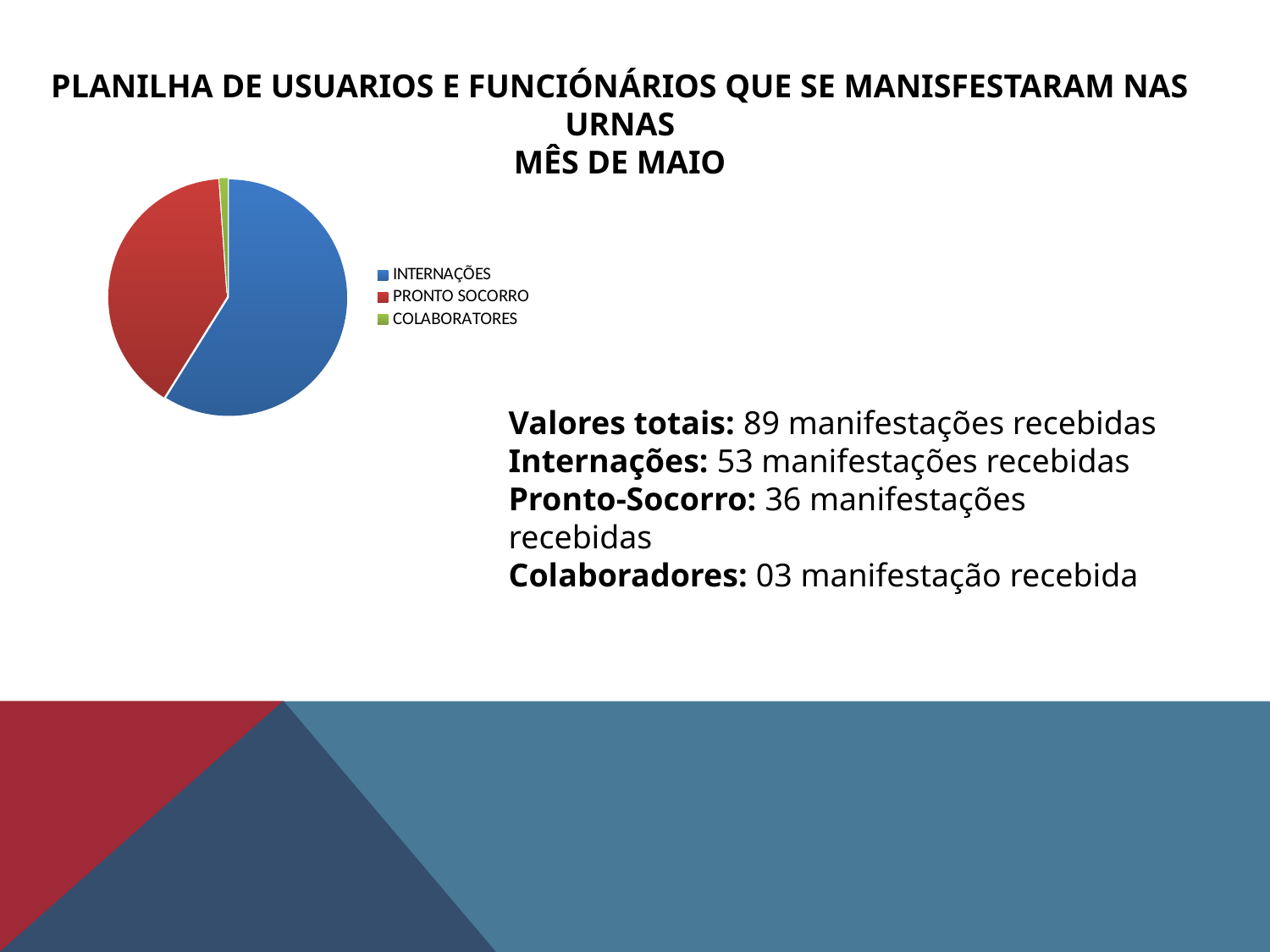
How many manifestações recebidas are reported for Colaboradores? 03 How many manifestações recebidas are reported for Internações? 53 What kind of chart is shown on the slide? pie chart Which slice is larger, INTERNAÇÕES or PRONTO SOCORRO? INTERNAÇÕES How many manifestações recebidas are reported for Pronto-Socorro? 36 Which slice is larger, PRONTO SOCORRO or COLABORATORES? PRONTO SOCORRO How many entries does the legend of the pie chart list? 3 Which category has the largest slice of the pie chart? INTERNAÇÕES What colour is the INTERNAÇÕES slice in the pie chart? blue What is the difference between the number of manifestações for Internações and for Pronto-Socorro? 17 Which category has the smallest slice of the pie chart? COLABORATORES How many slices does the pie chart have? 3